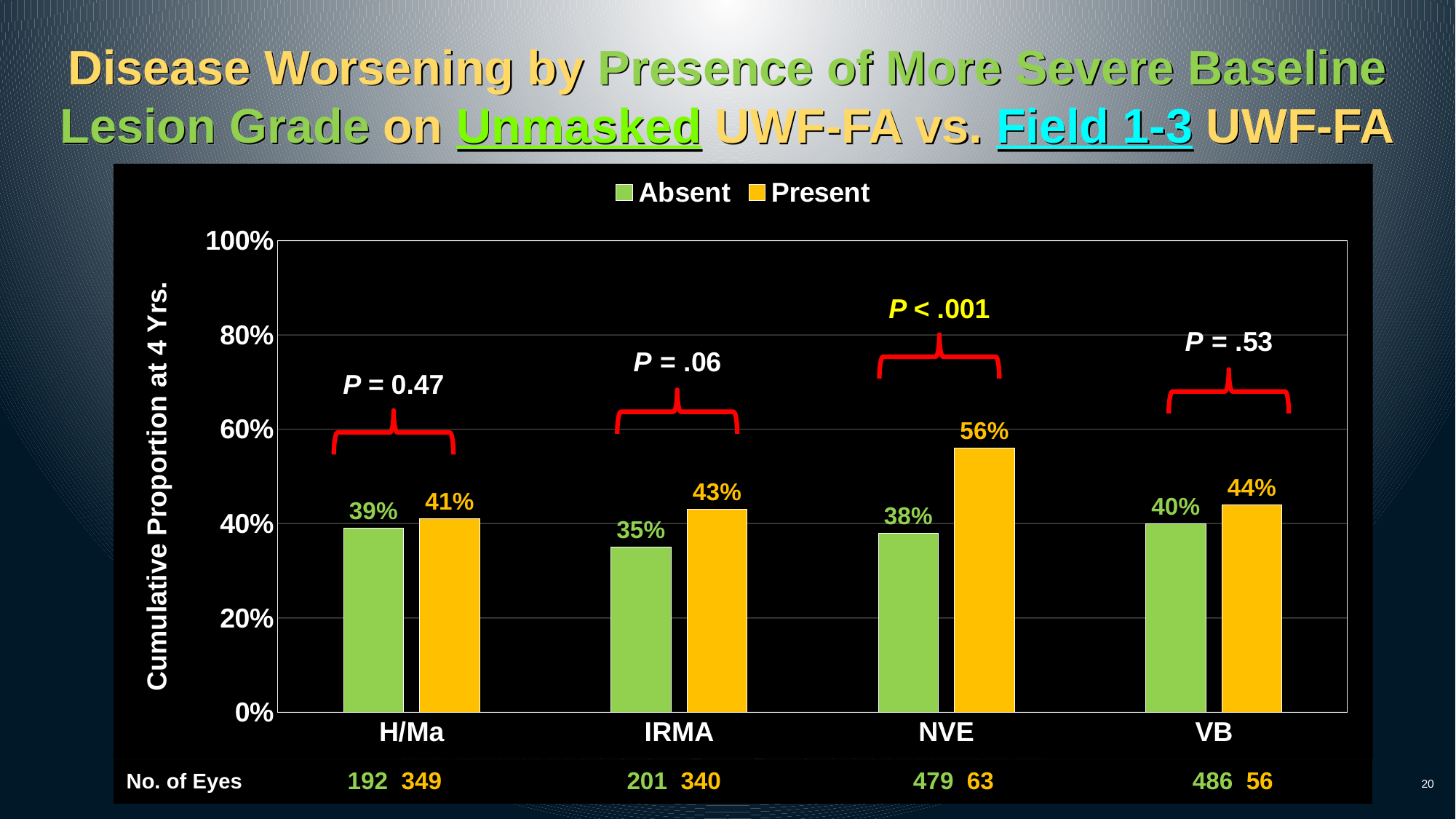
What is the cumulative proportion at 4 years for the Absent group in the IRMA category? 35% What is the value for the Present group in the H/Ma category? 41% What is the difference between the Present and Absent values in the NVE category? 18% What kind of chart is shown on the slide? Bar chart How many series does the legend list? 2 Which category has the highest value for the Present series? NVE In the IRMA category, which group has the larger value, Absent or Present? Present Which category has the lowest value for the Absent series? IRMA What is the difference between the Present and Absent values in the VB category? 4% How many categories are shown on the x axis? 4 What is the label of the y axis? Cumulative Proportion at 4 Yrs. What is the cumulative proportion at 4 years for the Present group in the NVE category? 56%